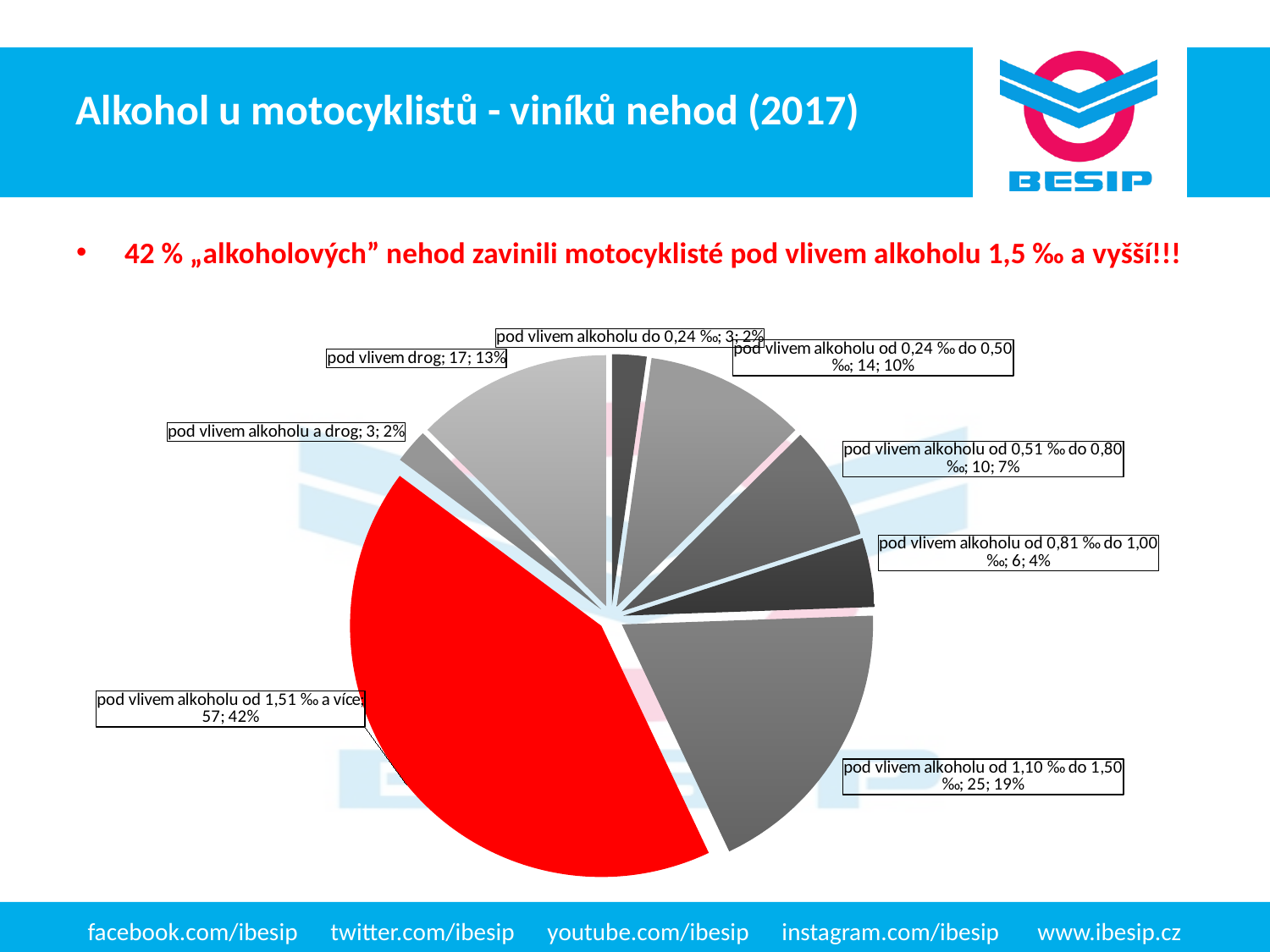
What is the difference between the values for "pod vlivem alkoholu od 1,51 ‰ a více" and "pod vlivem alkoholu od 1,10 ‰ do 1,50 ‰"? 32 How many slices does the pie chart have? 8 What kind of chart is shown on the slide? pie chart What share of the pie does "pod vlivem alkoholu od 1,10 ‰ do 1,50 ‰" represent? 19% What colour is the slice for "pod vlivem alkoholu od 1,51 ‰ a více"? red Which category has the largest slice of the pie? pod vlivem alkoholu od 1,51 ‰ a více What is the total of all the values shown in the pie chart? 135 What is the value for "pod vlivem alkoholu od 1,51 ‰ a více"? 57 What is the value for "pod vlivem alkoholu od 0,24 ‰ do 0,50 ‰"? 14 What is the value for "pod vlivem drog"? 17 What share of the pie does "pod vlivem alkoholu od 1,51 ‰ a více" represent? 42% Which is larger, the value for "pod vlivem drog" or the value for "pod vlivem alkoholu od 0,51 ‰ do 0,80 ‰"? pod vlivem drog